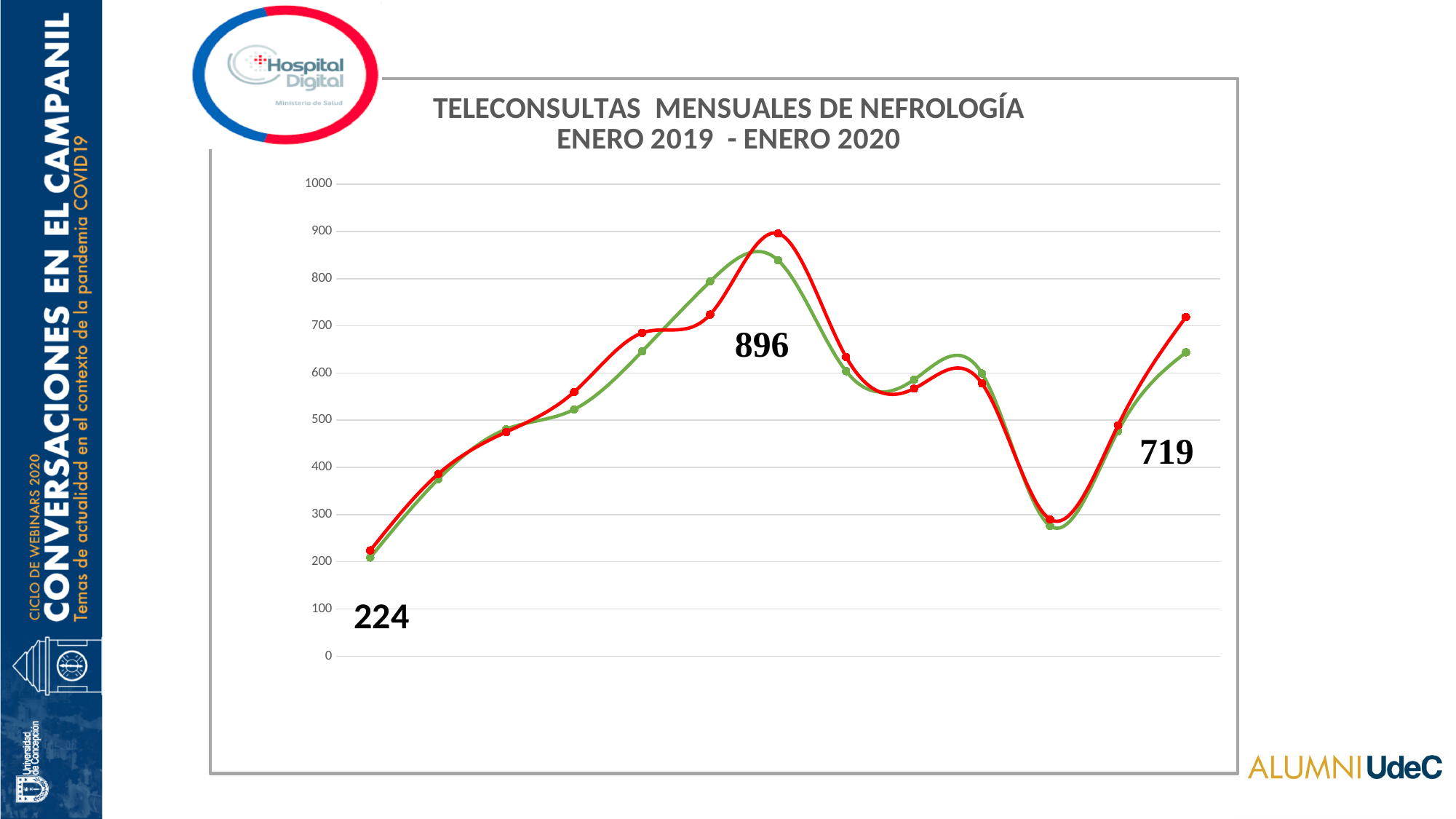
What is the highest value labelled on the chart? 896 What is the difference between the labelled peak value 896 and the labelled starting value 224? 672 What kind of chart is shown on the slide? line chart What is the value labelled at the first point of the red line? 224 What is the difference between the labelled peak value 896 and the labelled final value 719? 177 What is the title of the chart? TELECONSULTAS MENSUALES DE NEFROLOGÍA ENERO 2019 - ENERO 2020 Is the final point of the green line greater or less than 700? less How many lines are plotted on the chart? 2 What is the value labelled at the last point of the red line? 719 Which is larger, the labelled starting value or the labelled final value of the red line? the final value (719) How many data points does each line have? 13 Overall, from the first point to the last point, do the values rise or fall? rise